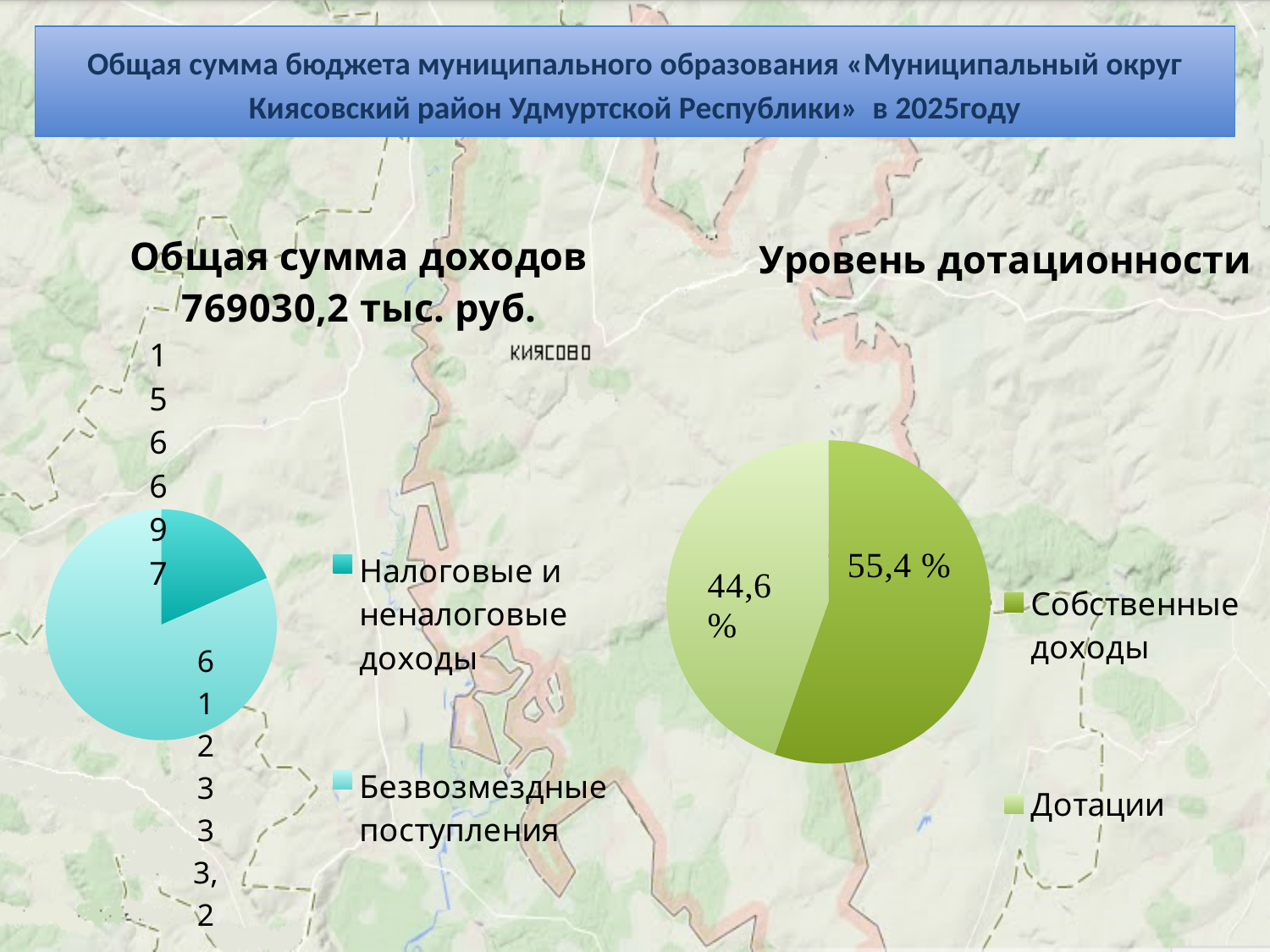
How many slices does the "Уровень дотационности" chart have? 2 In the "Общая сумма доходов" chart, what is the value for Безвозмездные поступления? 612333,2 What total sum of income is stated in the title of the left chart? 769030,2 тыс. руб. In the "Уровень дотационности" chart, what is the difference between Собственные доходы and Дотации? 10,8 % How many entries does the legend of the "Уровень дотационности" chart list? 2 In the "Уровень дотационности" chart, what is the value for Дотации? 44,6 % In the "Общая сумма доходов" chart, which category has the smallest slice? Налоговые и неналоговые доходы In the "Уровень дотационности" chart, which slice is larger: Собственные доходы or Дотации? Собственные доходы In the "Уровень дотационности" chart, what is the value for Собственные доходы? 55,4 % In the "Общая сумма доходов" chart, which category has the largest slice? Безвозмездные поступления What kind of chart is the "Общая сумма доходов" chart on the left? pie chart What kind of chart is the "Уровень дотационности" chart on the right? pie chart